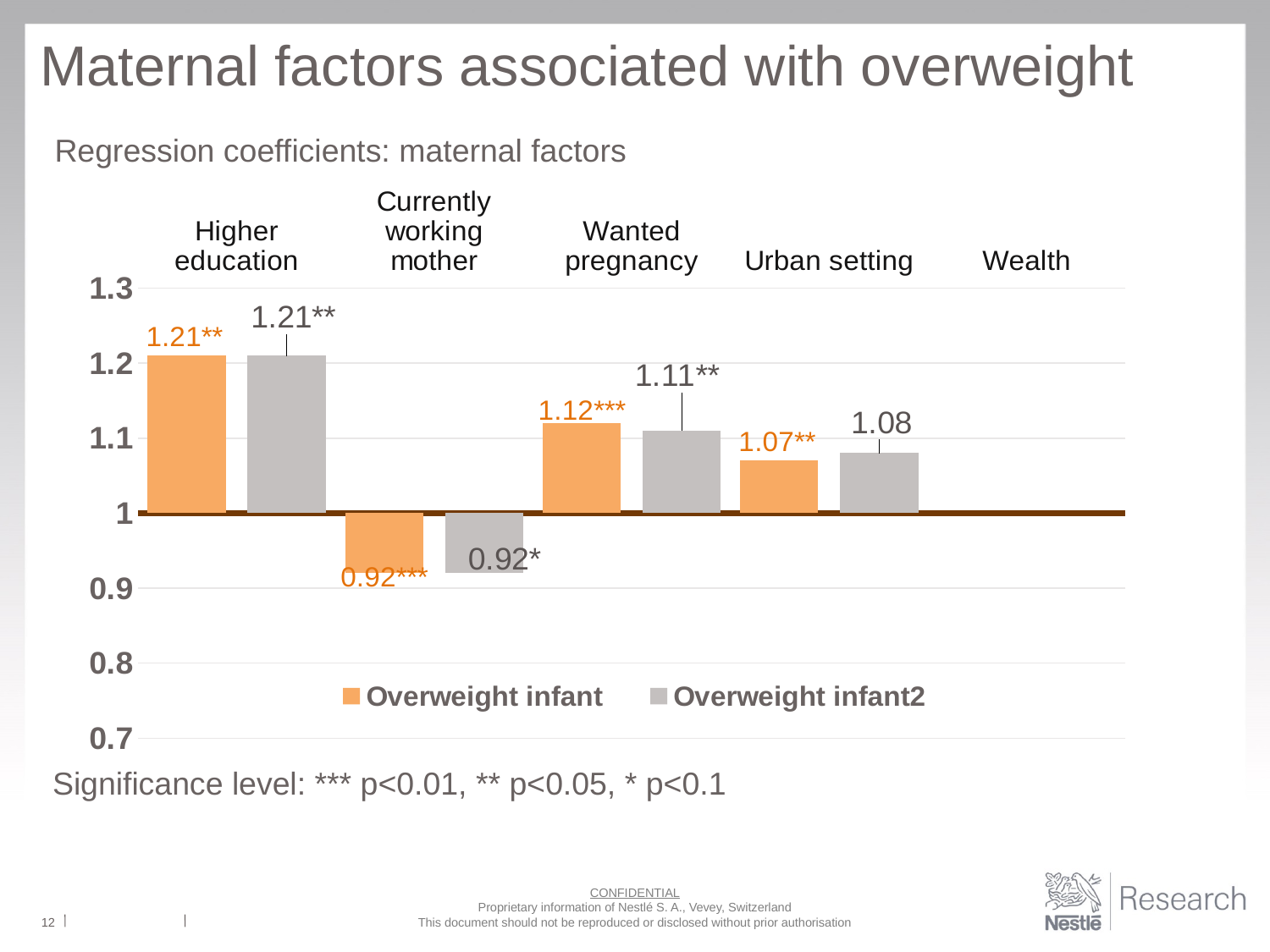
What is the value labelled for Overweight infant in the Urban setting category? 1.07** Which category has the highest Overweight infant value? Higher education Which category has the lowest Overweight infant value? Currently working mother How many categories are shown on the x axis of the chart? 5 What is the value labelled for Overweight infant2 in the Wanted pregnancy category? 1.11** How many series does the legend list? 2 What is the difference between the Overweight infant values for Higher education (1.21) and Urban setting (1.07)? 0.14 Is the Overweight infant value for Currently working mother greater or less than 1? less What is the value labelled for Overweight infant2 in the Urban setting category? 1.08 For the Overweight infant series, which is larger: Wanted pregnancy or Urban setting? Wanted pregnancy What is the value labelled for Overweight infant in the Higher education category? 1.21** What kind of chart is shown on the slide? bar chart